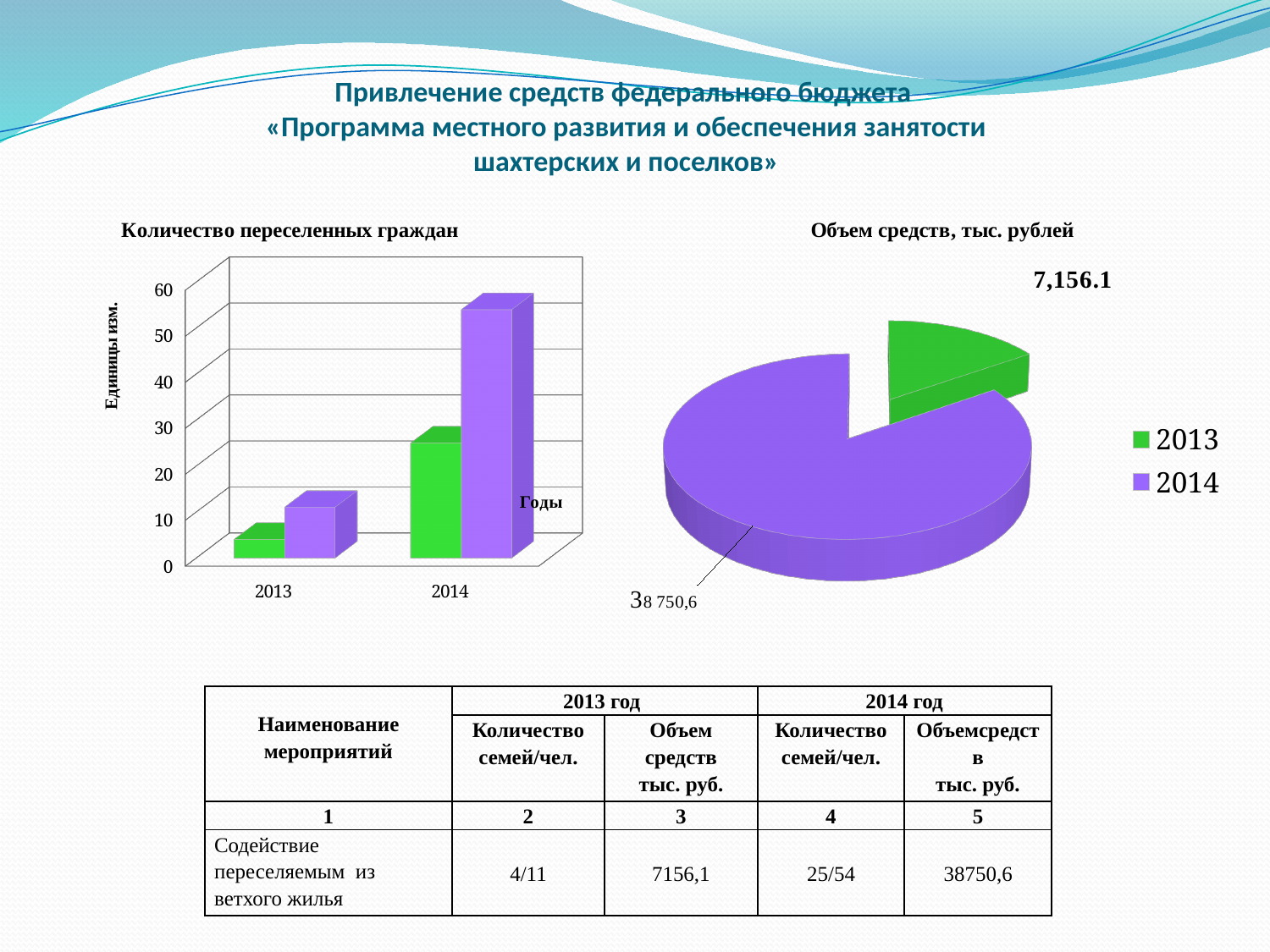
In the pie chart «Объем средств, тыс. рублей», which year has the larger slice? 2014 What is the label on the vertical axis of the bar chart «Количество переселенных граждан»? Единицы изм. How many years are shown on the x axis of the bar chart «Количество переселенных граждан»? 2 How many entries does the legend of the pie chart «Объем средств, тыс. рублей» list? 2 What kind of chart is the left chart titled «Количество переселенных граждан»? bar chart In the bar chart «Количество переселенных граждан», is the green bar for 2013 greater or less than 10? less In the bar chart «Количество переселенных граждан», is the purple bar for 2014 greater or less than 40? greater In the pie chart «Объем средств, тыс. рублей», what value is shown for 2013? 7,156.1 In the bar chart «Количество переселенных граждан», do the values rise or fall from 2013 to 2014? rise In the pie chart «Объем средств, тыс. рублей», what value is shown for 2014? 38 750,6 In the bar chart «Количество переселенных граждан», which year has the taller bars? 2014 What kind of chart is the right chart titled «Объем средств, тыс. рублей»? pie chart